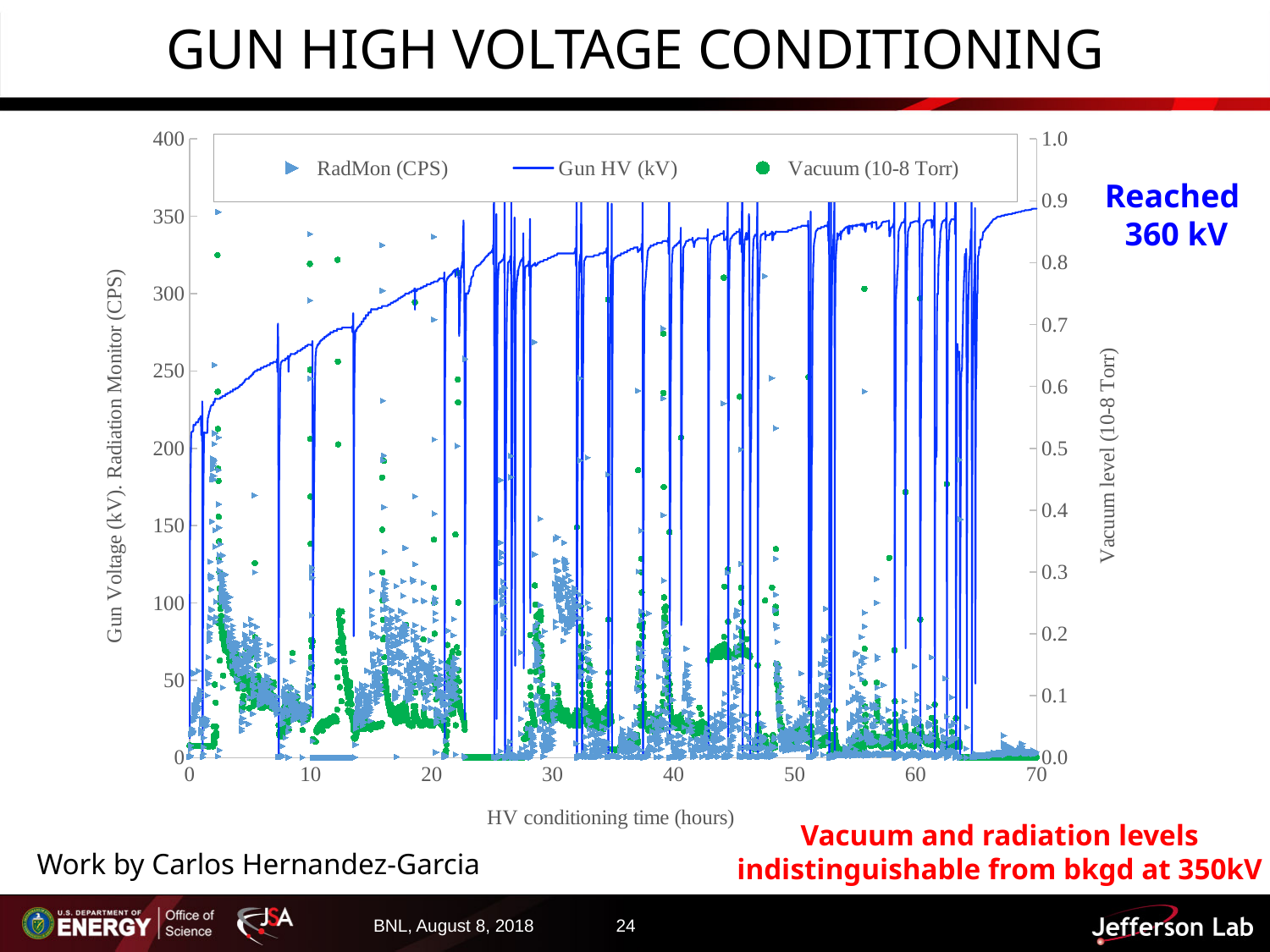
Is the Gun HV (kV) value at 0 hours greater or less than 250? less What is the title of the x axis of the chart? HV conditioning time (hours) What is the highest tick value shown on the left y axis of the chart? 400 Is the Gun HV (kV) value at 30 hours greater or less than 300? greater Is the Gun HV (kV) value at 20 hours greater or less than 350? less Does the Gun HV (kV) line generally rise or fall as HV conditioning time increases? rise What is the highest tick value shown on the x axis of the chart? 70 How many series does the chart legend list? 3 What are the three series named in the chart legend? RadMon (CPS), Gun HV (kV), Vacuum (10-8 Torr) What is the highest tick value shown on the right y axis (Vacuum level) of the chart? 1.0